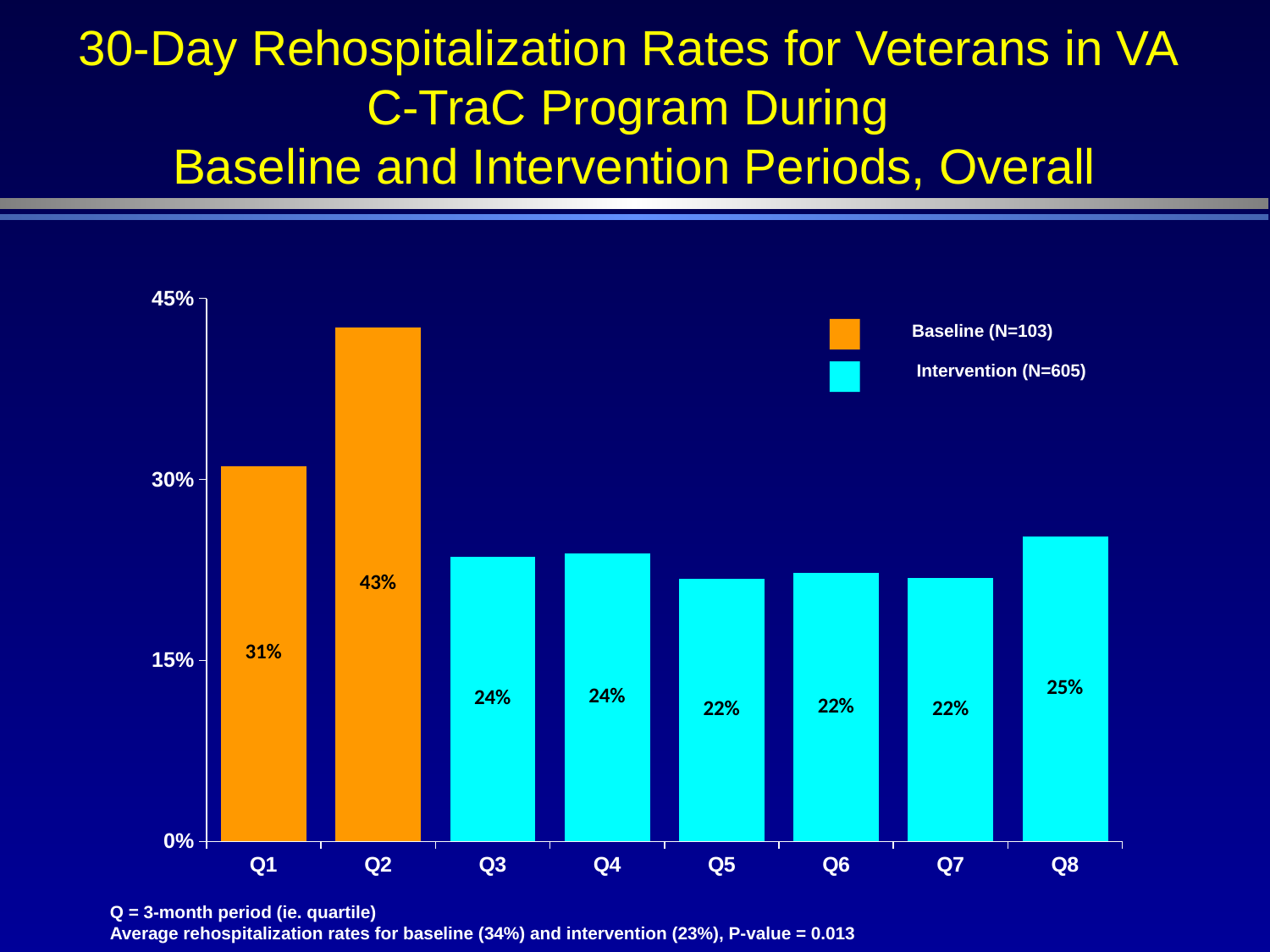
What is the difference between the rehospitalization rates for Q2 and Q1? 12% What is the sample size (N) for the Intervention series in the legend? 605 Which is larger, the rehospitalization rate for Q1 or for Q3? Q1 Is the rehospitalization rate for Q2 greater or less than 30%? greater What is the 30-day rehospitalization rate for Q2? 43% What kind of chart is shown on the slide? Bar chart What is the 30-day rehospitalization rate for Q8? 25% What is the difference between the rehospitalization rates for Q8 and Q5? 3% How many quarters are shown on the x axis? 8 Which quarter has the highest rehospitalization rate? Q2 How many series does the legend list? 2 What is the 30-day rehospitalization rate for Q1? 31%